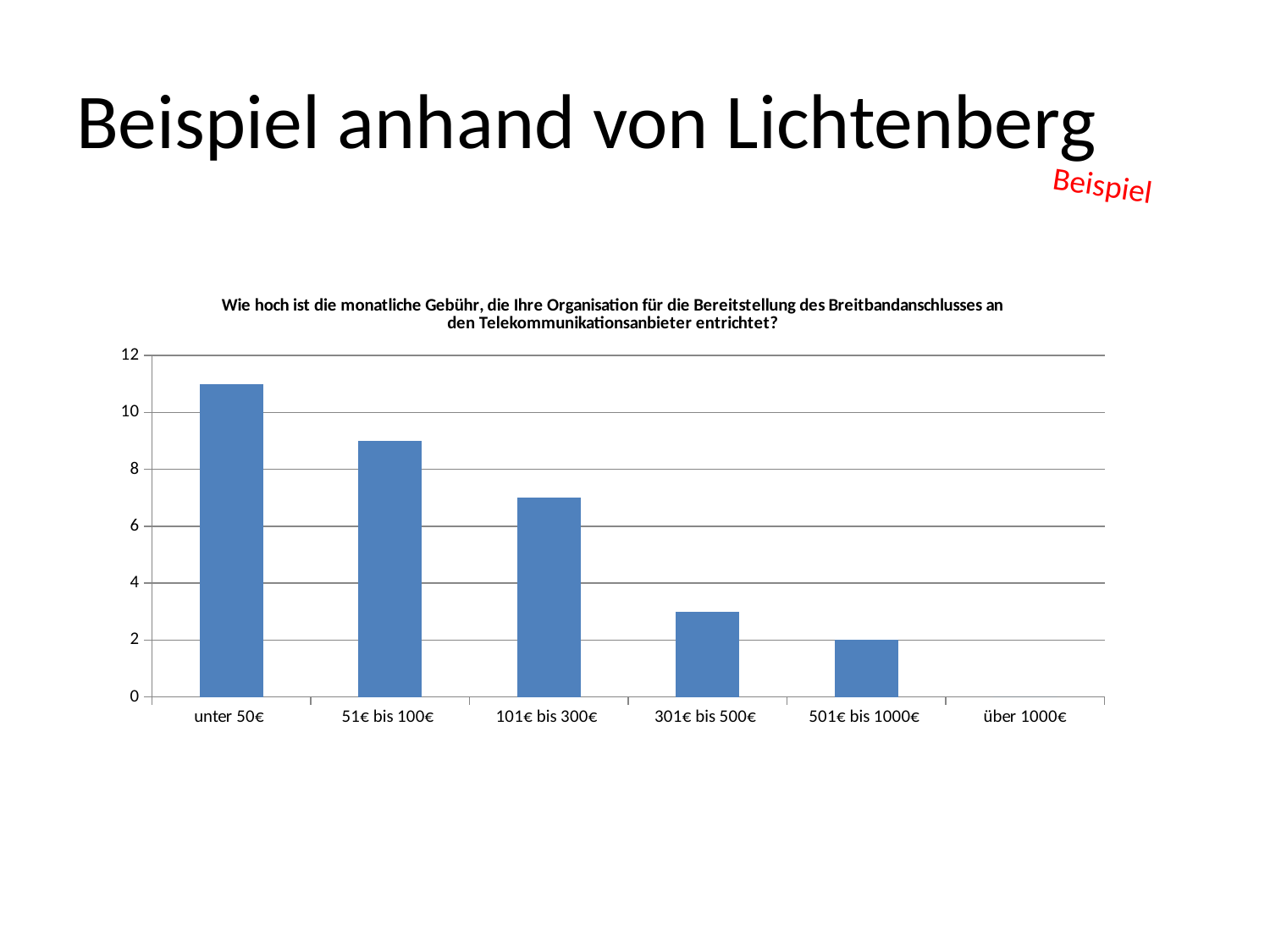
What is the value for the category über 1000€? 0 Is the value for 101€ bis 300€ greater or less than 8? less Which category has the lowest value in the chart? über 1000€ Is the value for unter 50€ greater or less than 10? greater Do the values rise or fall from left to right along the x axis? fall Which is larger, the value for unter 50€ or the value for 101€ bis 300€? unter 50€ Which category has the highest bar in the chart? unter 50€ Is the value for 51€ bis 100€ greater or less than 8? greater What is the value for the category 501€ bis 1000€? 2 How many categories are shown on the x axis of the chart? 6 What kind of chart is shown on the slide? bar chart